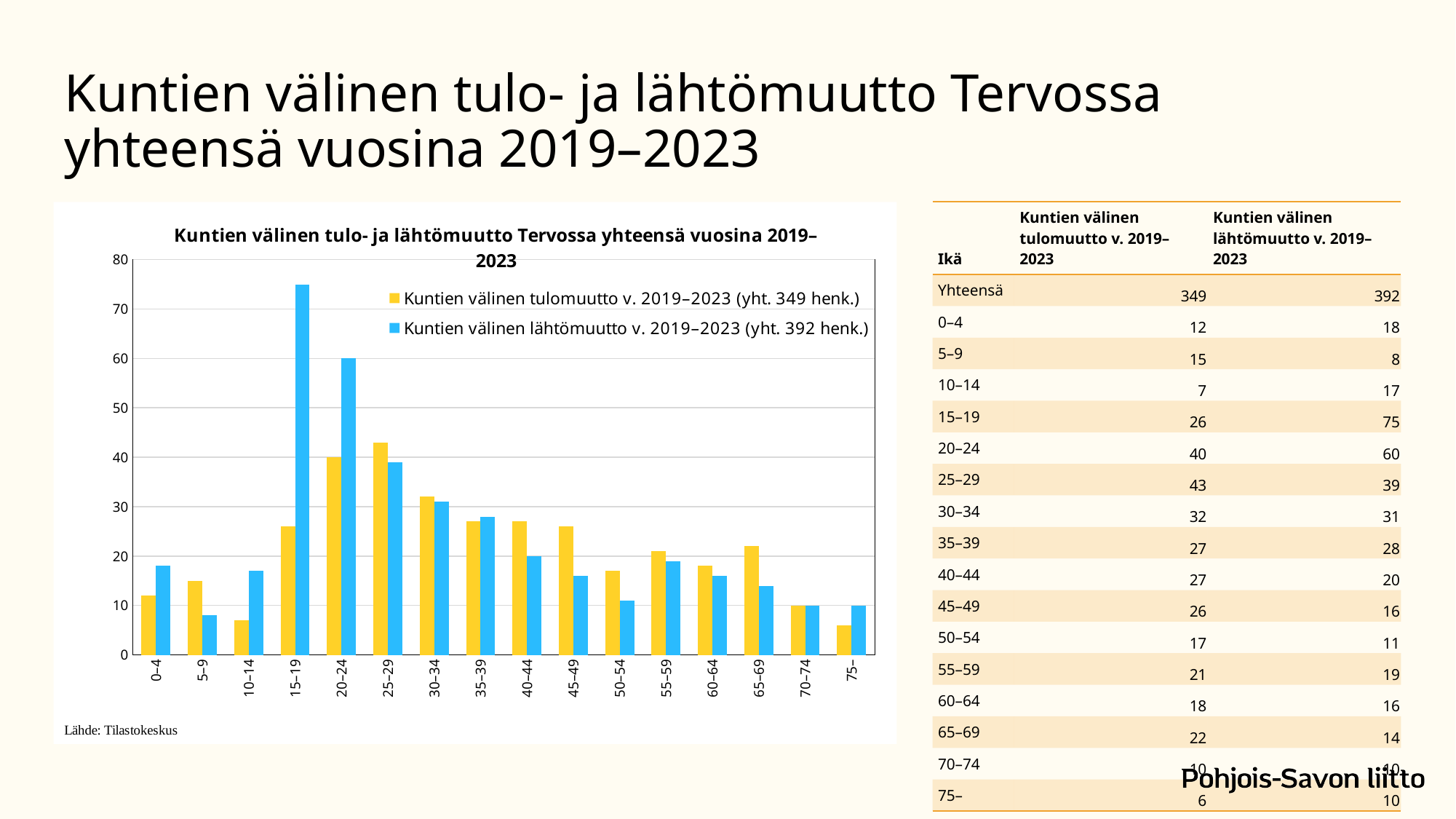
According to the legend, what is the total number of people (yht.) for Kuntien välinen lähtömuutto v. 2019–2023? 392 henk. For the 45–49 age group, which is larger: tulomuutto or lähtömuutto? tulomuutto What kind of chart is shown on the slide? bar chart What is the value of Kuntien välinen tulomuutto v. 2019–2023 for the 20–24 age group? 40 What is the value of Kuntien välinen lähtömuutto v. 2019–2023 for the 15–19 age group? 75 How many series does the chart's legend list? 2 Which age group has the highest value for Kuntien välinen lähtömuutto v. 2019–2023? 15–19 What is the difference between lähtömuutto and tulomuutto for the 15–19 age group? 49 Which age group has the lowest value for Kuntien välinen tulomuutto v. 2019–2023? 75– Is the value of Kuntien välinen lähtömuutto v. 2019–2023 for the 20–24 age group greater or less than 50? greater How many age groups are shown on the x axis of the chart? 16 Which age group has the highest value for Kuntien välinen tulomuutto v. 2019–2023? 25–29